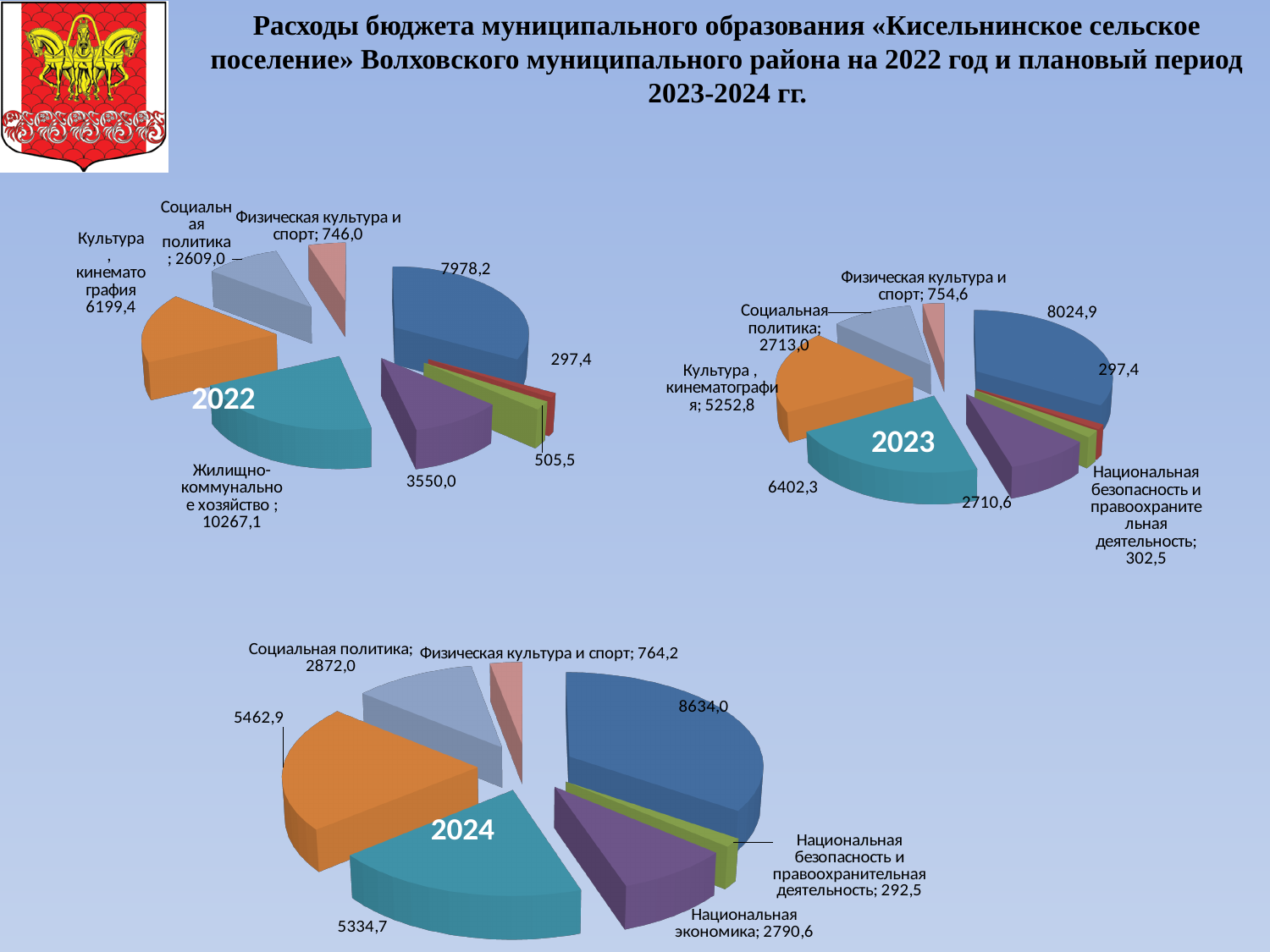
In the 2024 chart, which category has the smallest slice? Национальная безопасность и правоохранительная деятельность What is the difference between the Социальная политика values in the 2023 chart and the 2022 chart? 104,0 In the 2024 chart, what is the value for Национальная экономика? 2790,6 In the 2023 chart, what is the value for Национальная безопасность и правоохранительная деятельность? 302,5 How many pie charts are shown on the slide? 3 What kind of chart is used for the 2022 data? pie chart In the 2022 chart, what is the value for Жилищно-коммунальное хозяйство? 10267,1 In the 2023 chart, what is the value for Культура, кинематография? 5252,8 In the 2022 chart, which is larger: Социальная политика or Физическая культура и спорт? Социальная политика In the 2024 chart, what is the largest value shown? 8634,0 In the 2022 chart, what is the value for Социальная политика? 2609,0